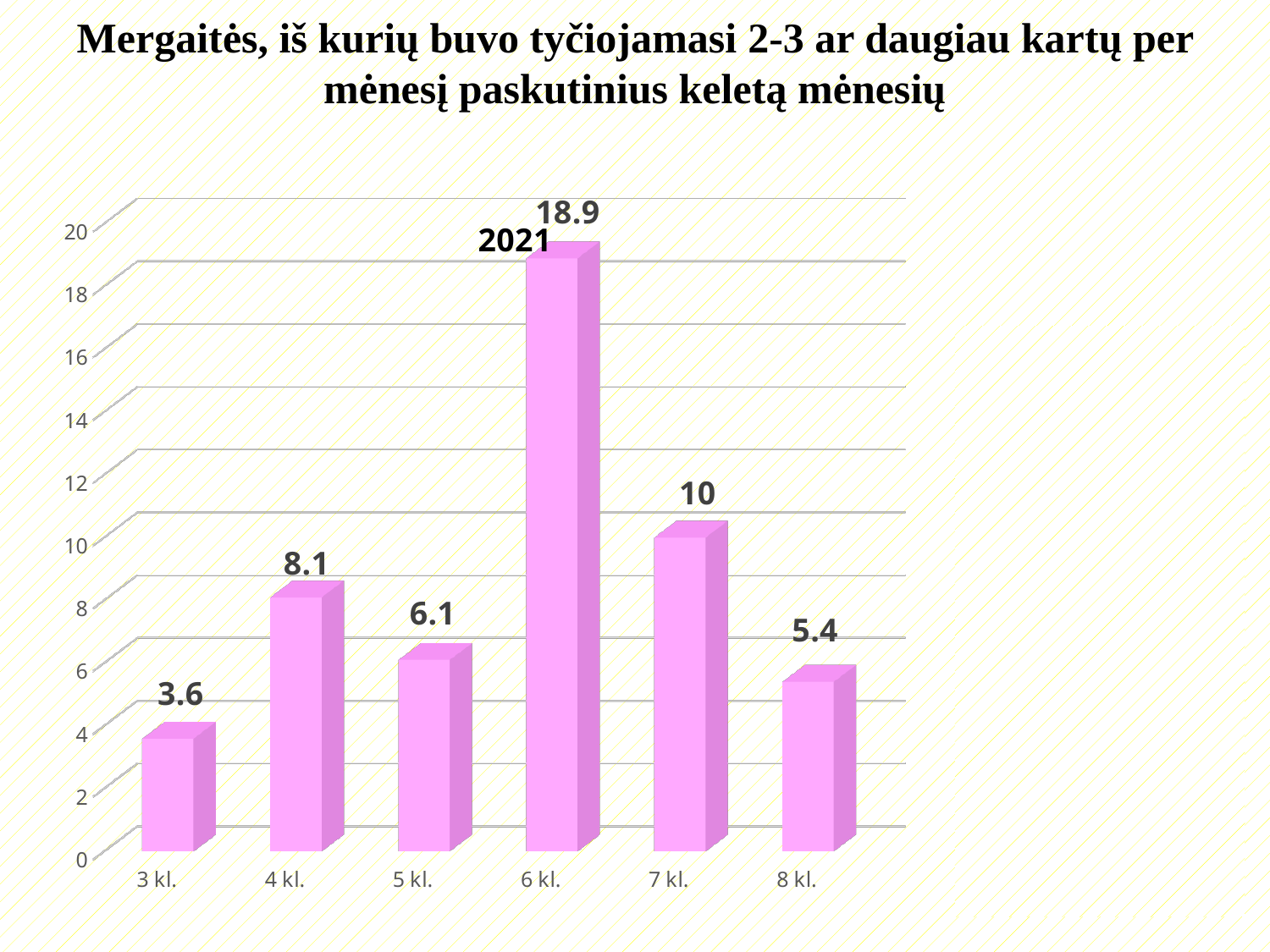
What is the value for 8 kl.? 5.4 Which is larger, the value for 4 kl. or the value for 8 kl.? 4 kl. Do the values rise or fall from 6 kl. to 8 kl.? fall How many categories are shown on the x axis? 6 What is the difference between the values for 4 kl. and 5 kl.? 2 Which category has the highest value? 6 kl. What is the difference between the values for 6 kl. and 7 kl.? 8.9 What is the value for 3 kl.? 3.6 What year label is printed next to the tallest bar? 2021 What kind of chart is this? bar chart Which category has the lowest value? 3 kl. What is the value for 6 kl.? 18.9